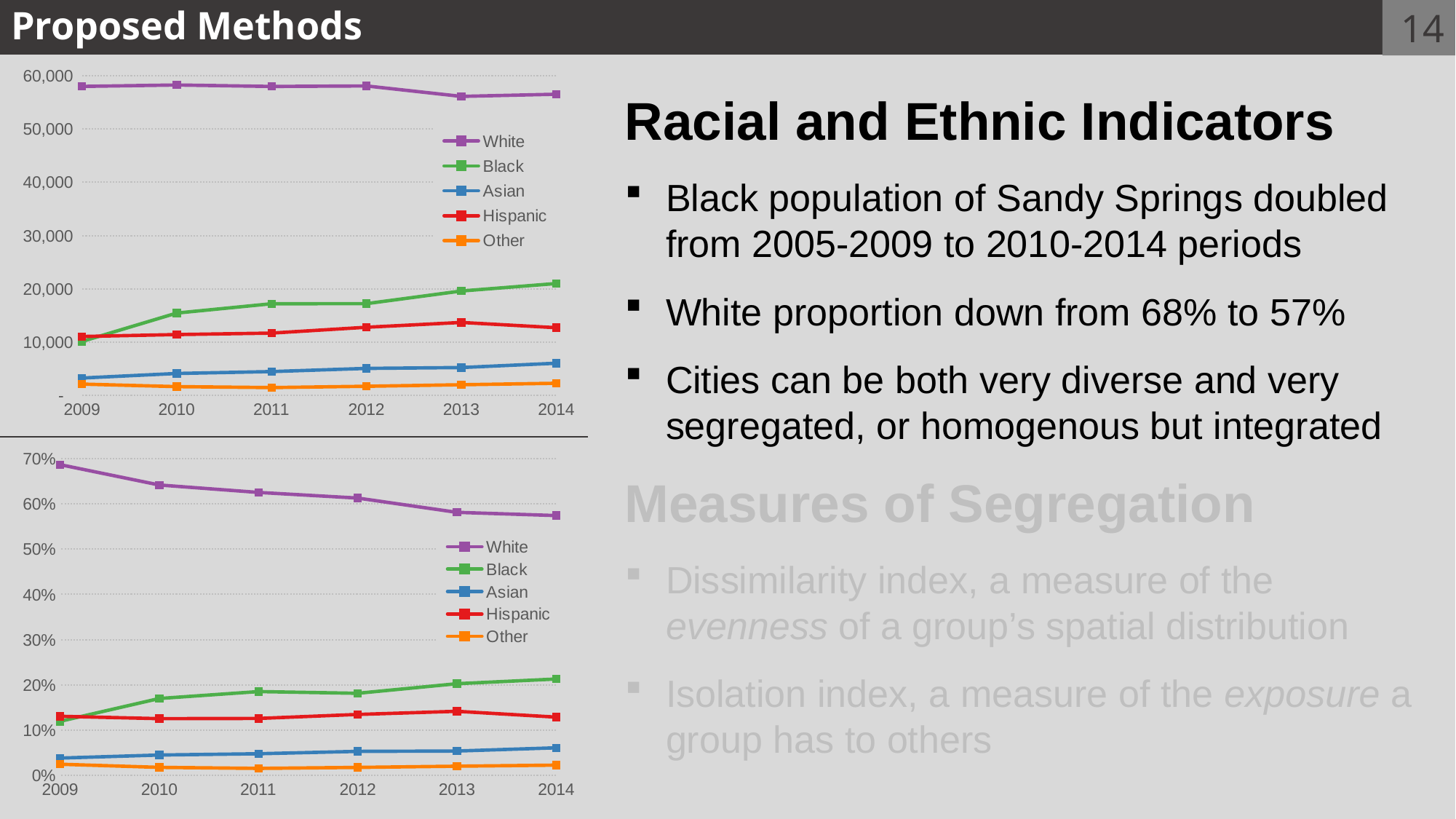
In the bottom chart, which series is shown in orange? Other In the top chart, which series has the lowest values across all years? Other In the bottom chart, is the value for White in 2014 greater or less than 60%? less In the top chart, which series has the highest values across all years? White In the top chart, which is larger in 2014, Black or Hispanic? Black In the bottom chart, does the Black line rise or fall from 2009 to 2014? rise How many years are plotted along the x axis of the top chart? 6 In the bottom chart, does the White line rise or fall from 2009 to 2014? fall In the top chart, is the value for Asian in 2014 greater or less than 10,000? less How many series does the legend of the bottom chart list? 5 In the top chart, is the value for White in 2009 greater or less than 50,000? greater What kind of chart is the top chart on the slide? line chart